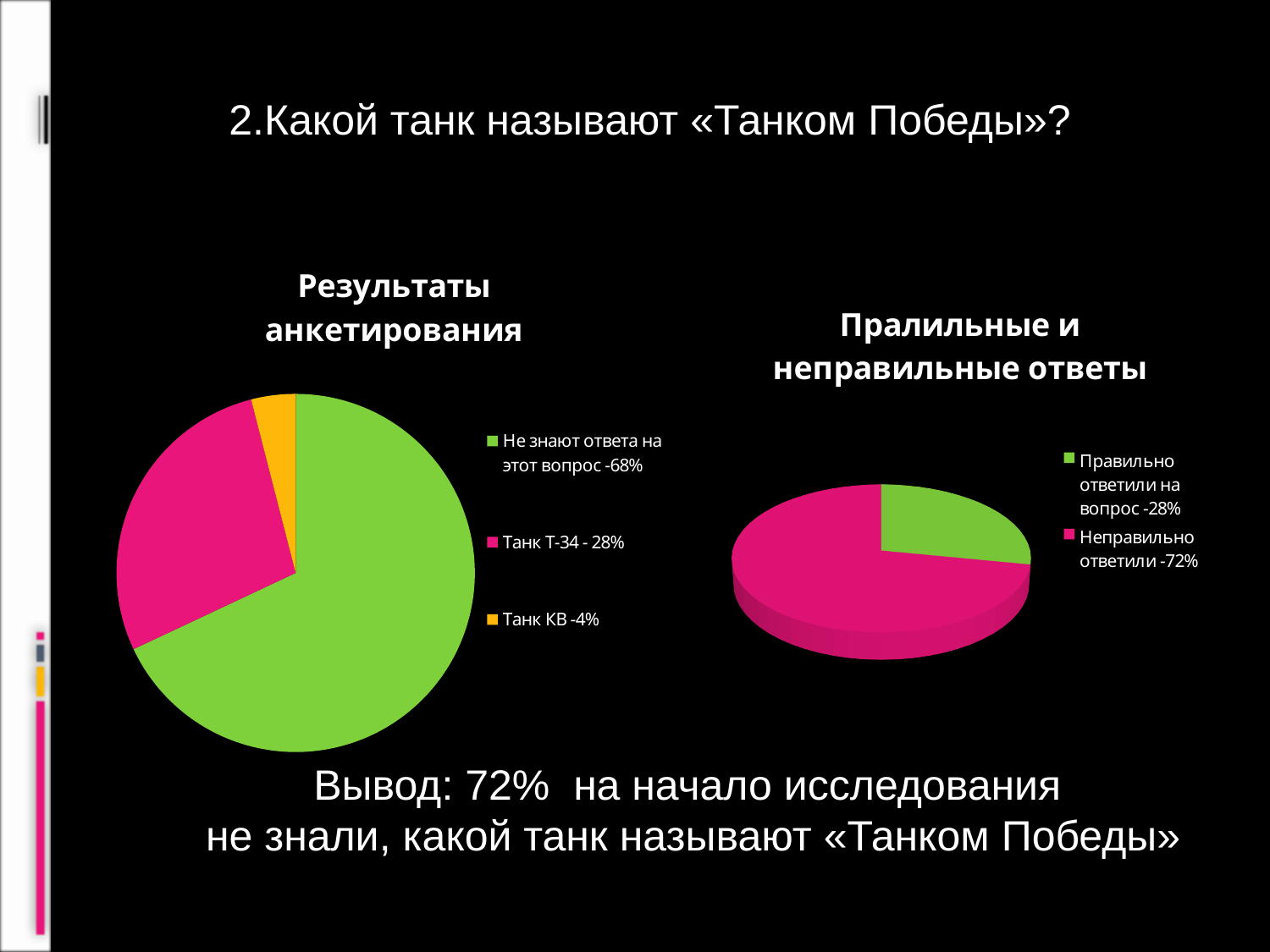
What kind of chart is the 'Результаты анкетирования' chart? pie chart In the 'Результаты анкетирования' chart, which category has the smallest slice? Танк КВ In the 'Пралильные и неправильные ответы' chart, which is larger: 'Правильно ответили на вопрос' or 'Неправильно ответили'? Неправильно ответили In the 'Результаты анкетирования' chart, how many categories does the legend list? 3 In the 'Результаты анкетирования' chart, which category has the largest slice? Не знают ответа на этот вопрос In the 'Результаты анкетирования' chart, what share is shown for 'Танк Т-34'? 28% In the 'Пралильные и неправильные ответы' chart, what share is shown for 'Неправильно ответили'? 72% In the 'Результаты анкетирования' chart, what is the difference between the shares for 'Танк Т-34' and 'Танк КВ'? 24% In the 'Пралильные и неправильные ответы' chart, what share is shown for 'Правильно ответили на вопрос'? 28% In the 'Пралильные и неправильные ответы' chart, what colour is the 'Неправильно ответили' slice? pink In the 'Результаты анкетирования' chart, what share is shown for 'Танк КВ'? 4% In the 'Результаты анкетирования' chart, what share is shown for 'Не знают ответа на этот вопрос'? 68%